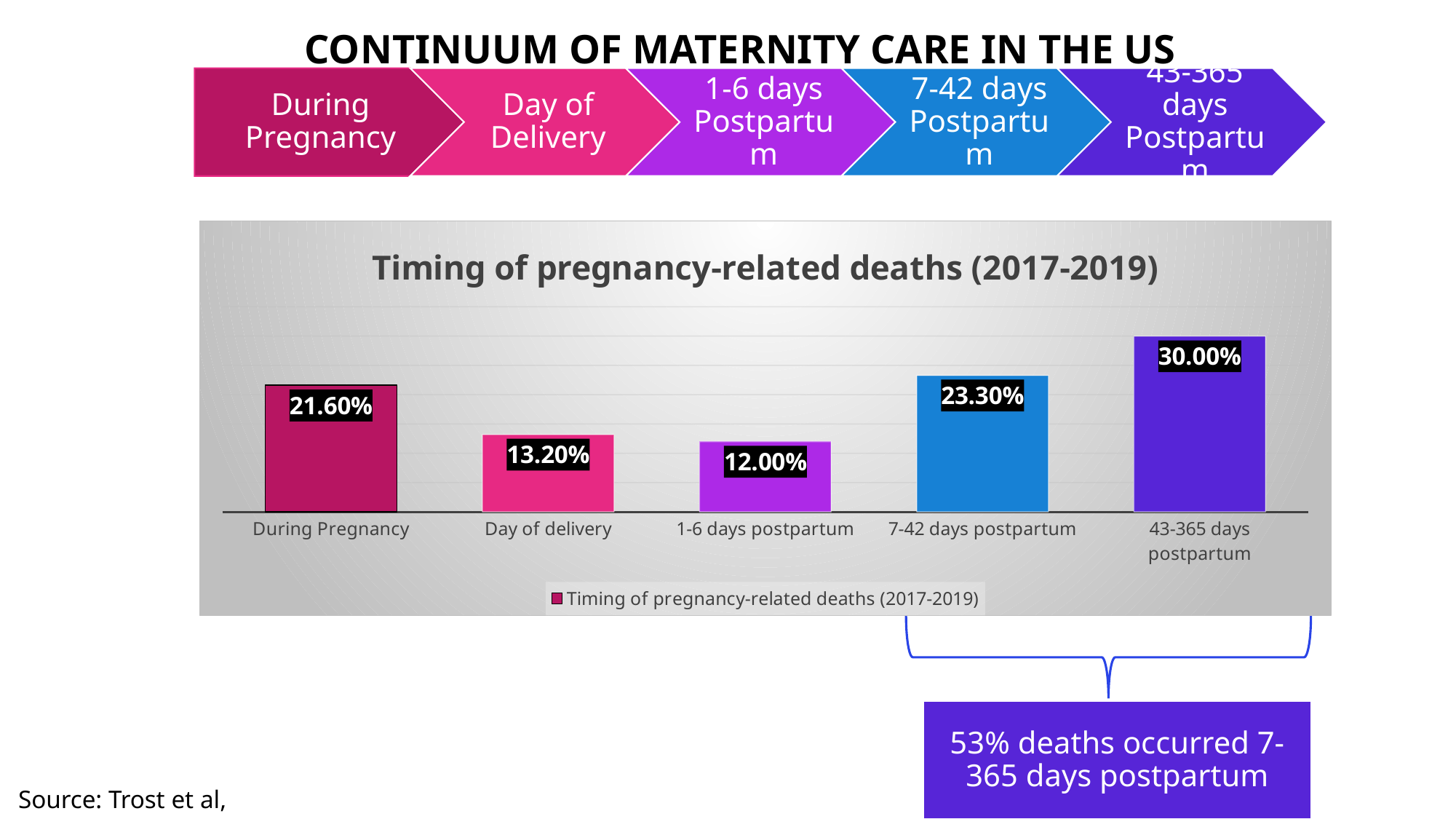
What is the value for During Pregnancy? 21.60% How many series does the legend list? 1 What is the value for 1-6 days postpartum? 12.00% What is the value for Day of delivery? 13.20% What is the value for 43-365 days postpartum? 30.00% Which category has the lowest value? 1-6 days postpartum What is the difference between the values for 43-365 days postpartum and 7-42 days postpartum? 6.70% What is the title of the chart? Timing of pregnancy-related deaths (2017-2019) Which category has the highest value? 43-365 days postpartum Which is larger, the value for During Pregnancy or the value for 7-42 days postpartum? 7-42 days postpartum What kind of chart is shown? bar chart How many categories are shown on the x axis? 5